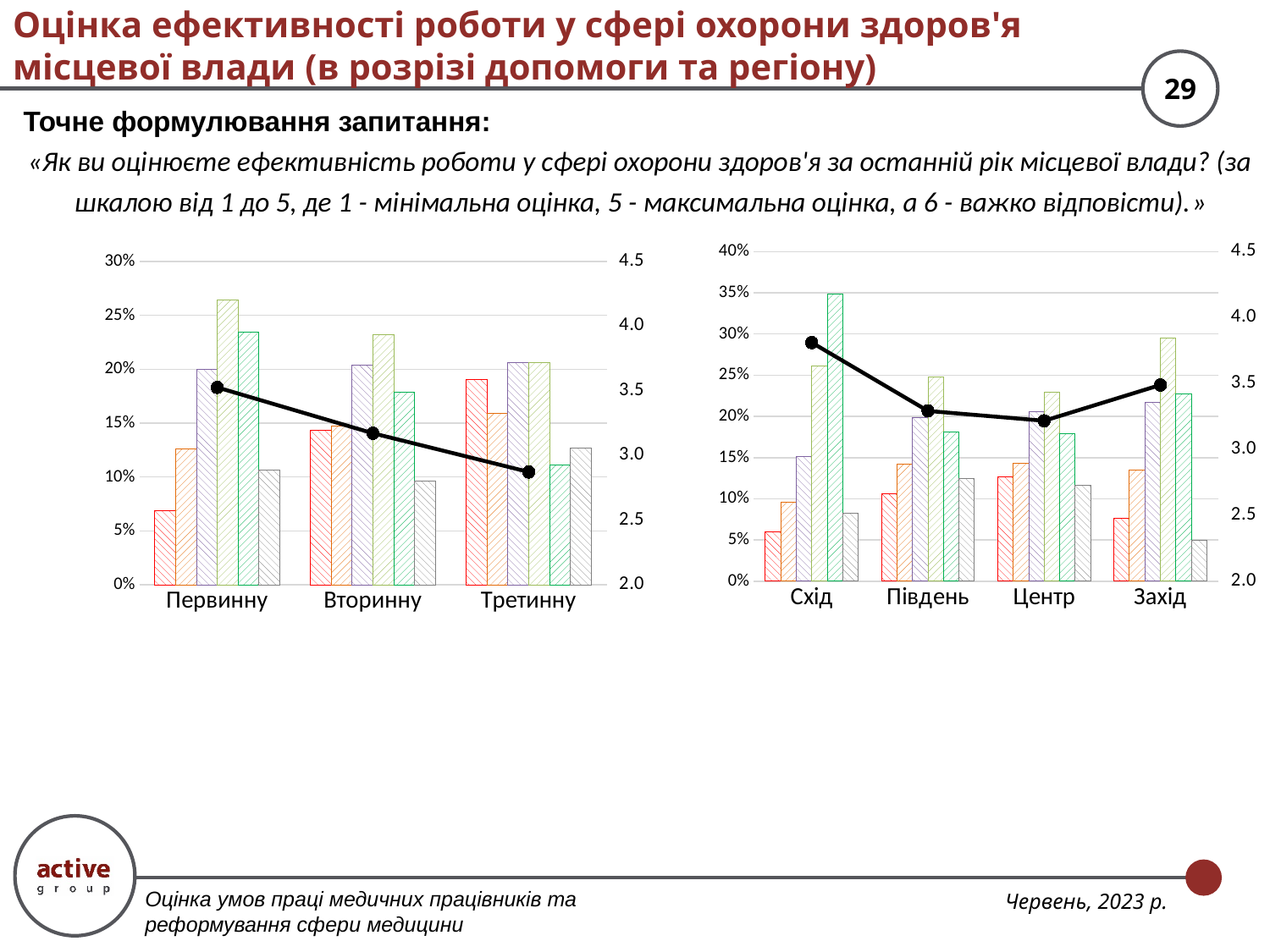
On the left chart, which category has the lowest value on the line? Третинну What kind of chart is the left chart? Bar chart combined with a line On the left chart, is the line value for Третинну greater or less than 3.0? less On the right chart, which region has the highest value on the line? Схід On the left chart, which category has the highest value on the line? Первинну On the right chart, is the tallest bar in the Схід group greater or less than 30%? greater On the left chart, does the line rise or fall from Первинну to Третинну? Falls On the right chart, is the line value for Схід greater or less than 3.5? greater How many categories are shown on the x axis of the left chart? 3 How many categories are shown on the x axis of the right chart? 4